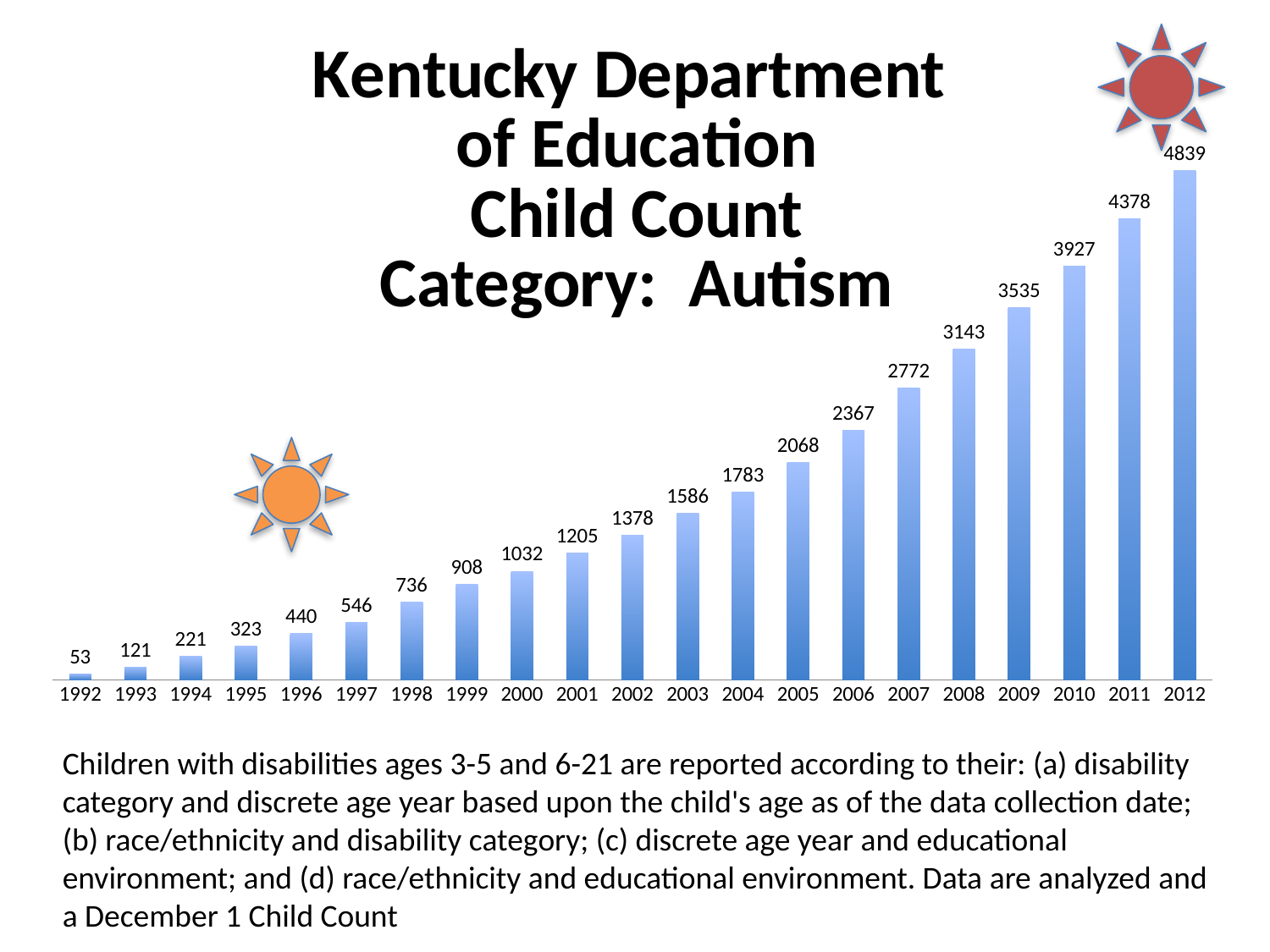
What is the child count for autism in 1998? 736 What is the child count for autism in 2012? 4839 Which year has the highest child count? 2012 What is the difference between the child count in 2000 and in 1999? 124 How many years are shown on the x axis? 21 Do the child count values rise or fall from 1992 to 2012? Rise Which year has a larger child count, 2003 or 2007? 2007 Which year has the lowest child count? 1992 What disability category does the chart title say the child count is for? Autism What is the child count for autism in 2005? 2068 What is the difference between the child count in 2012 and in 2011? 461 What kind of chart is shown on the slide? Bar chart